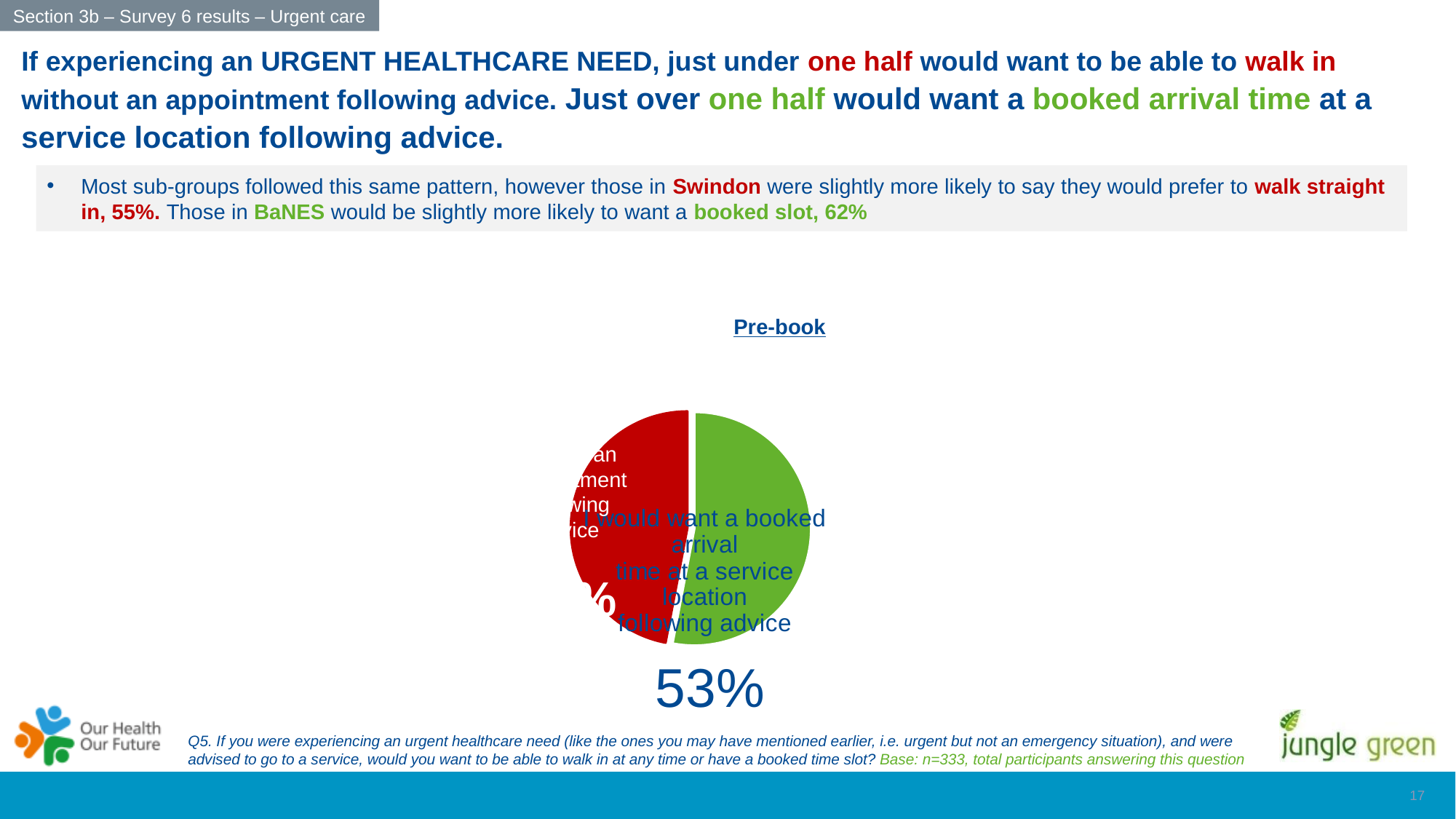
What colour is the slice for 'I would want a booked arrival time at a service location following advice'? green Is the share for 'I would want a booked arrival time at a service location following advice' greater or less than 50%? greater What kind of chart is shown on the slide? pie chart What percentage of respondents said they would want a booked arrival time at a service location following advice? 53% Which slice of the pie chart is larger: the booked arrival time slice or the walk-in slice? the booked arrival time slice What is the title shown above the pie chart? Pre-book How many slices does the pie chart have? 2